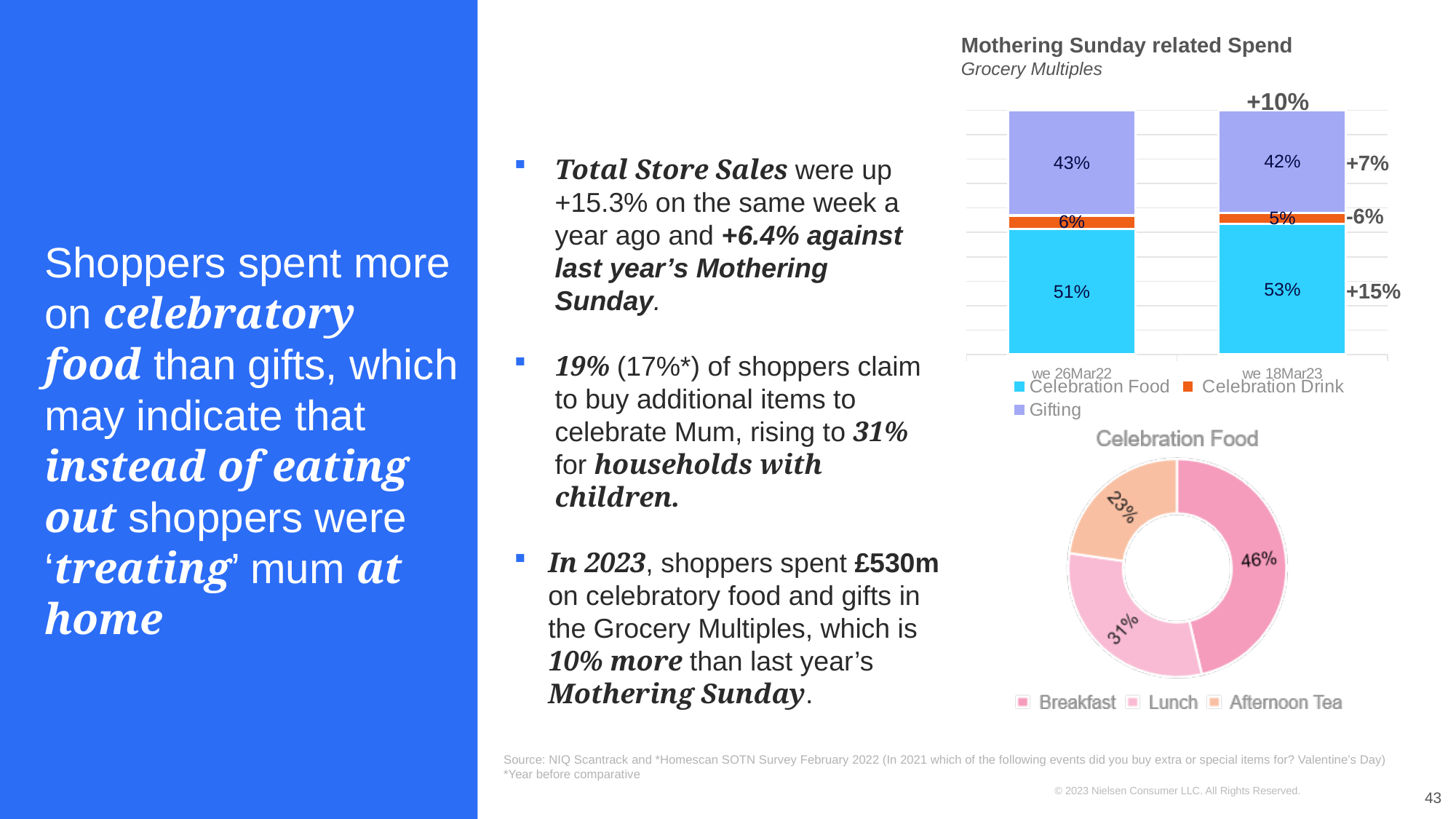
In the 'Mothering Sunday related Spend' chart, what share of spend was Gifting in the week ending 26Mar22? 43% In the 'Mothering Sunday related Spend' chart, what is the total of the stacked bar for we 18Mar23? 100% In the 'Mothering Sunday related Spend' chart, what share of spend was Celebration Drink in the week ending 18Mar23? 5% In the 'Mothering Sunday related Spend' chart, what share of spend was Celebration Food in the week ending 18Mar23? 53% In the 'Mothering Sunday related Spend' chart, by how many percentage points did the Celebration Food share change from we 26Mar22 to we 18Mar23? 2 percentage points In the 'Mothering Sunday related Spend' chart, how many series does the legend list? 3 How many categories are shown in the 'Celebration Food' donut chart? 3 In the 'Celebration Food' donut chart, which category has the smallest share? Afternoon Tea In the 'Celebration Food' donut chart, what is the difference between the Lunch and Afternoon Tea shares? 8 percentage points In the 'Celebration Food' donut chart, what share does Breakfast have? 46% What type of chart is the 'Mothering Sunday related Spend' chart? Stacked bar chart In the 'Mothering Sunday related Spend' chart, which segment is the smallest in the week ending 26Mar22? Celebration Drink